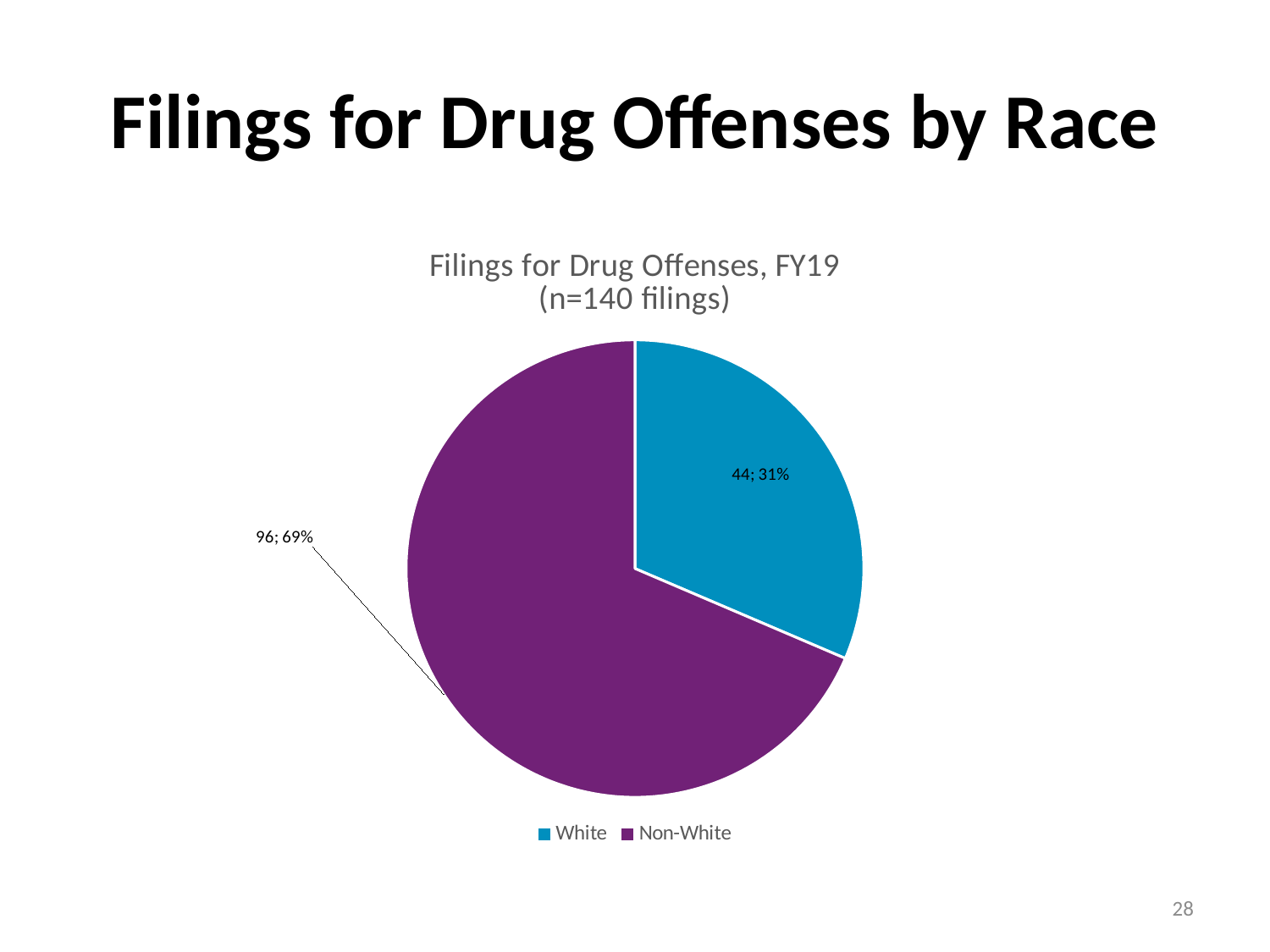
How many filings are shown for Non-White? 96 Which category has the smallest slice of the pie? White How many categories does the pie chart show? 2 What is the title of the chart? Filings for Drug Offenses, FY19 (n=140 filings) How many filings are shown for White? 44 What colour is the Non-White slice? purple What percentage of filings does the White slice represent? 31% What kind of chart is shown on the slide? pie chart Which category has the largest slice of the pie? Non-White What is the difference in the number of filings between Non-White and White? 52 Which has more filings, White or Non-White? Non-White What percentage of filings does the Non-White slice represent? 69%